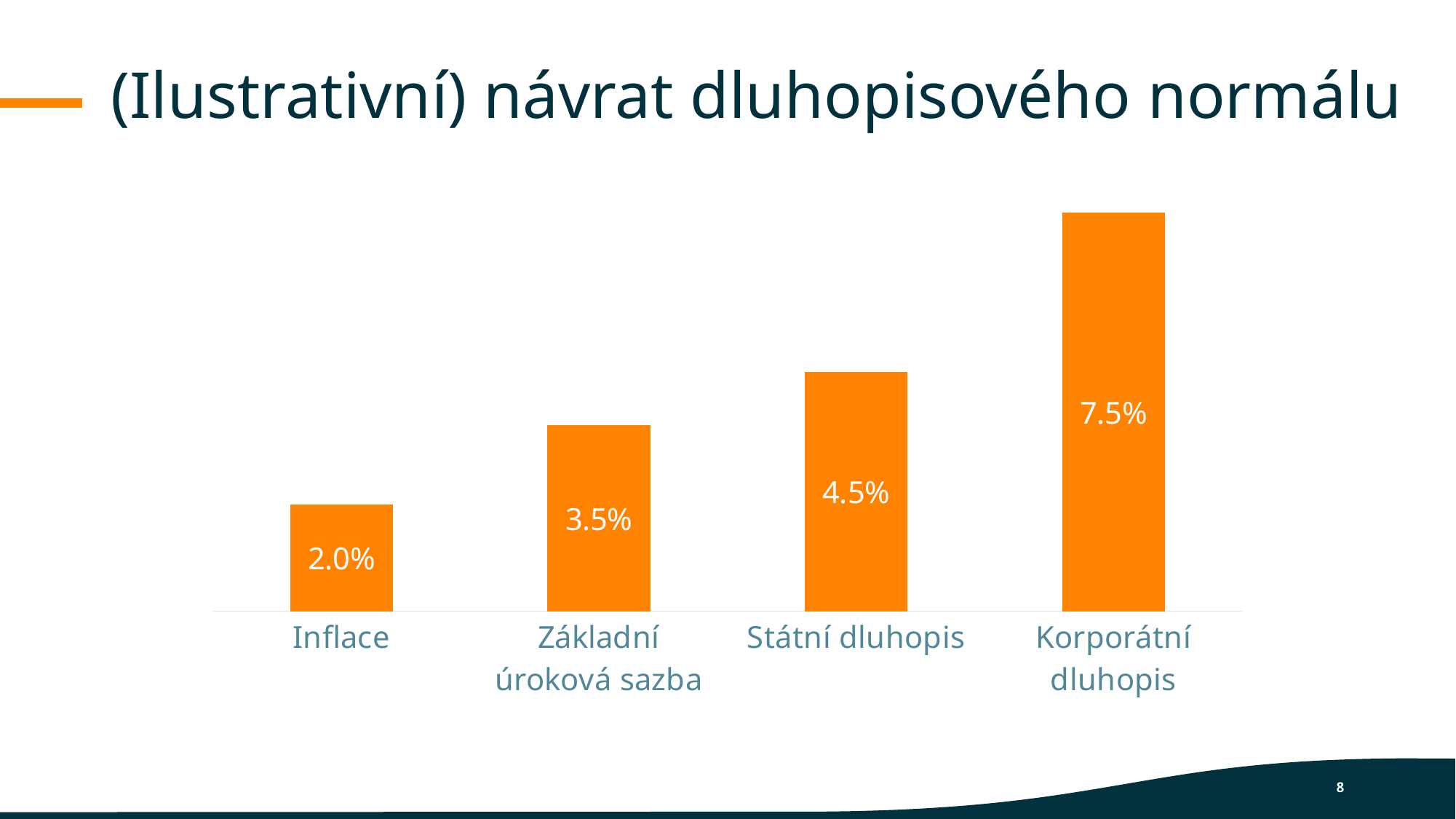
Do the values rise or fall from left to right along the x axis? Rise What is the value for Inflace? 2.0% How many categories are shown in the chart? 4 What is the difference between the values for Základní úroková sazba and Inflace? 1.5% Which is larger, the value for Státní dluhopis or the value for Základní úroková sazba? Státní dluhopis What is the value for Korporátní dluhopis? 7.5% What is the value for Základní úroková sazba? 3.5% Which category has the lowest value? Inflace Which category has the highest value? Korporátní dluhopis What is the difference between the values for Korporátní dluhopis and Státní dluhopis? 3.0% What kind of chart is shown on the slide? Bar chart What is the value for Státní dluhopis? 4.5%